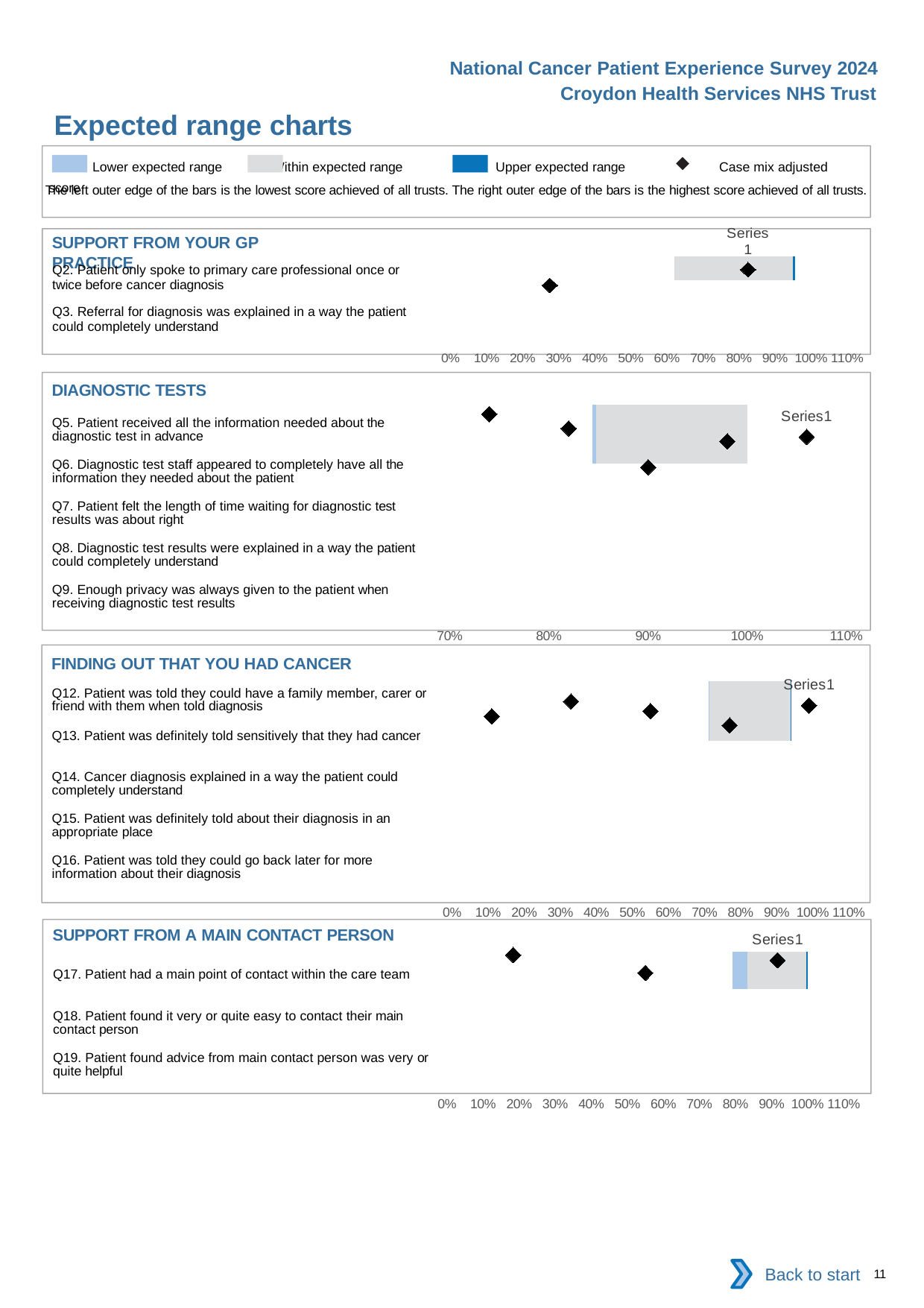
In the 'FINDING OUT THAT YOU HAD CANCER' chart, how many questions are listed? 5 In the 'FINDING OUT THAT YOU HAD CANCER' chart, which question is listed last? Q16. Patient was told they could go back later for more information about their diagnosis In the 'SUPPORT FROM A MAIN CONTACT PERSON' chart, what is the highest value shown on the x axis? 110% In the 'DIAGNOSTIC TESTS' chart, what is the lowest value shown on the x axis? 70% How many charts are shown on the slide? 4 In the 'SUPPORT FROM YOUR GP PRACTICE' chart, which question is listed first? Q2. Patient only spoke to primary care professional once or twice before cancer diagnosis In the 'SUPPORT FROM A MAIN CONTACT PERSON' chart, how many questions are listed? 3